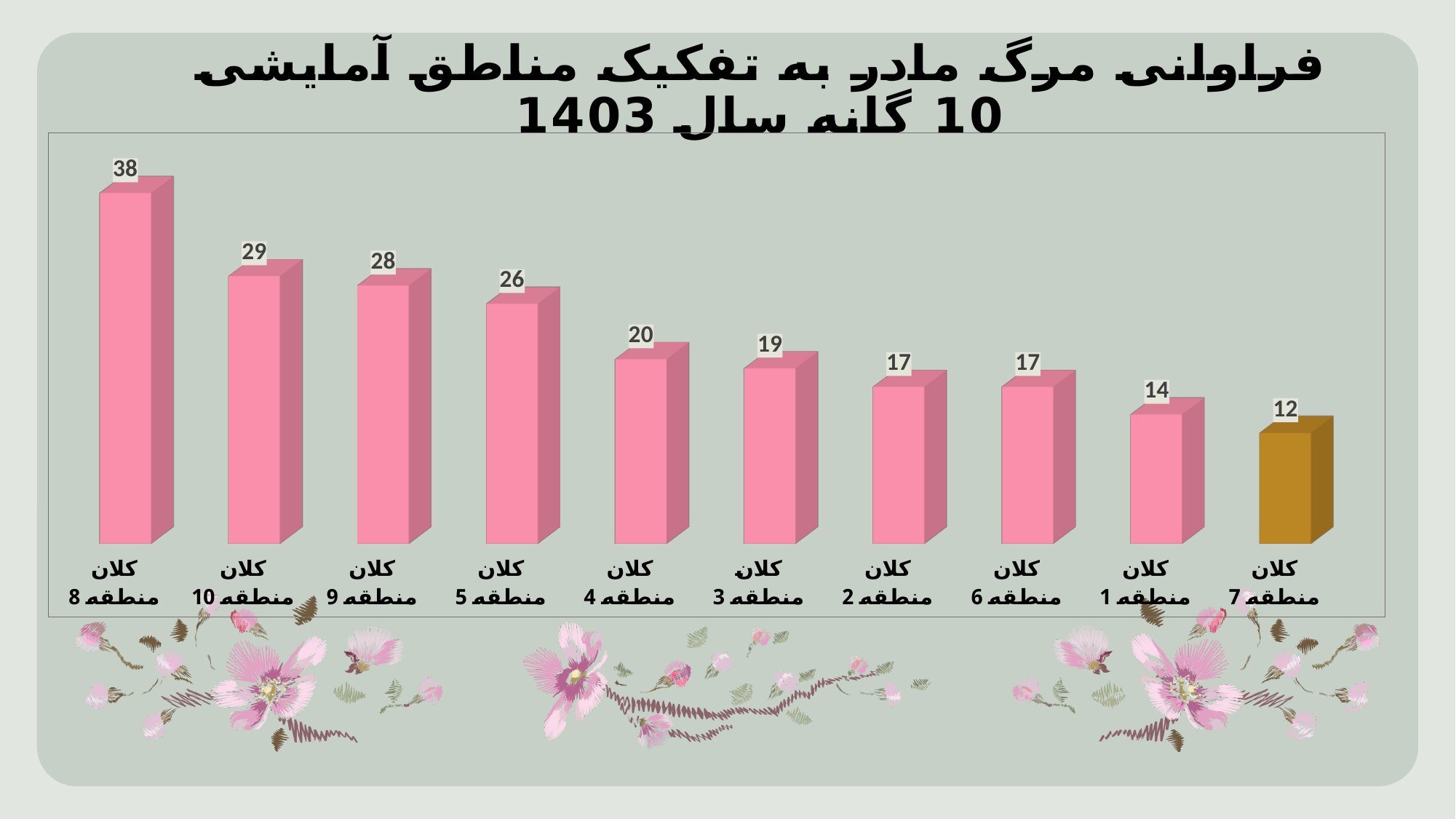
How many categories are shown in the chart? 10 What is the value for کلان منطقه 1? 14 What is the difference between the values for کلان منطقه 8 and کلان منطقه 7? 26 What is the difference between the values for کلان منطقه 10 and کلان منطقه 5? 3 Which category has the highest value? کلان منطقه 8 Which is larger, the value for کلان منطقه 9 or the value for کلان منطقه 3? کلان منطقه 9 What is the value for کلان منطقه 8? 38 Which bar is coloured differently from the others? کلان منطقه 7 What kind of chart is shown on the slide? Bar chart What is the value for کلان منطقه 4? 20 Do the values rise or fall from left to right across the chart? Fall Which category has the lowest value? کلان منطقه 7